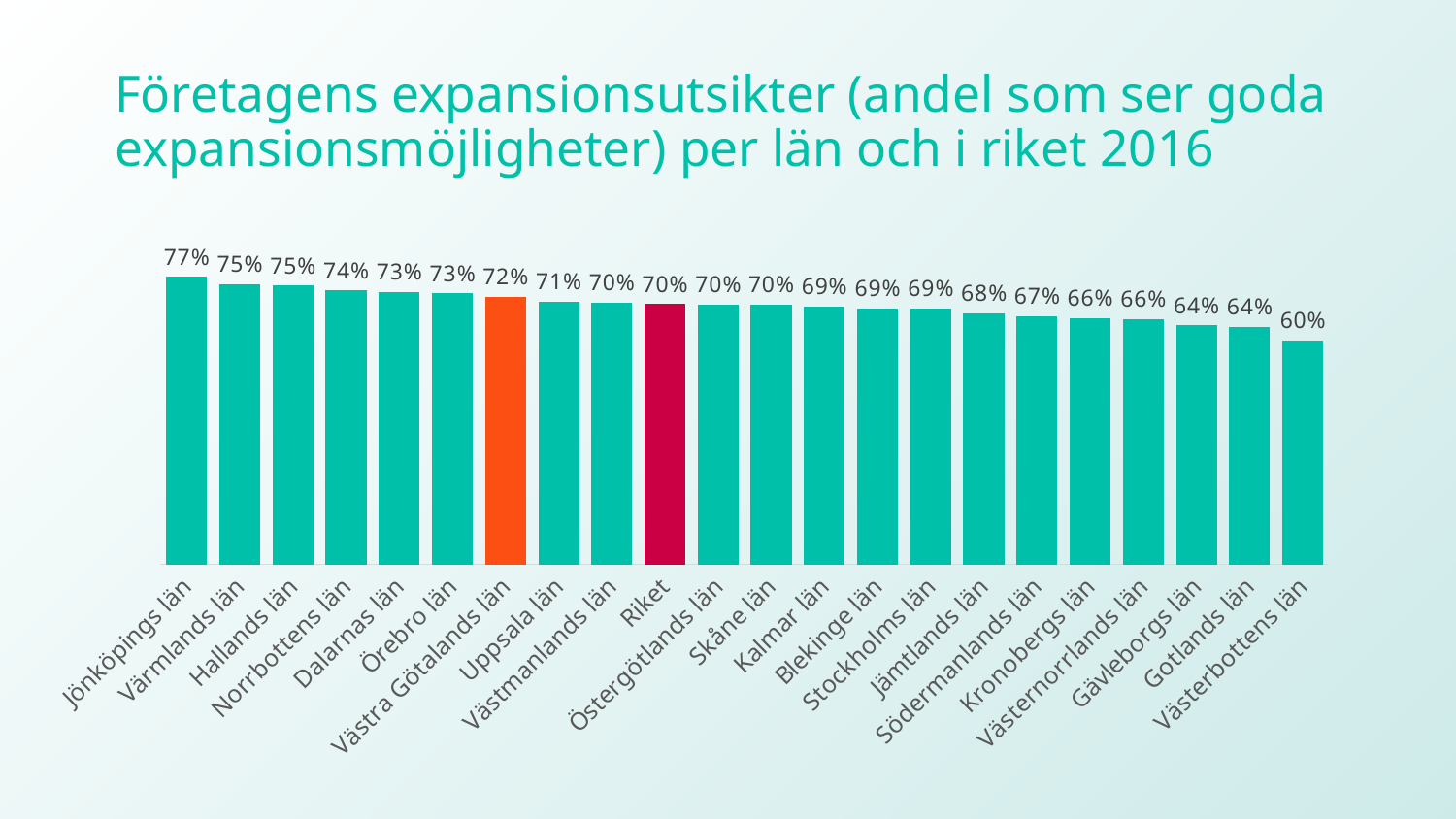
How many categories are shown in the chart? 22 What is the difference between the values for Västra Götalands län and Riket? 2 percentage points What is the value for Stockholms län? 69% Which category has the highest value? Jönköpings län Which category has the lowest value? Västerbottens län Do the values rise or fall from left to right along the x axis? Fall What kind of chart is shown on the slide? Bar chart What is the value for Riket? 70% Which is larger, the value for Norrbottens län or the value for Gotlands län? Norrbottens län What is the difference between the values for Jönköpings län and Västerbottens län? 17 percentage points What is the value for Jönköpings län? 77% What is the value for Västra Götalands län? 72%